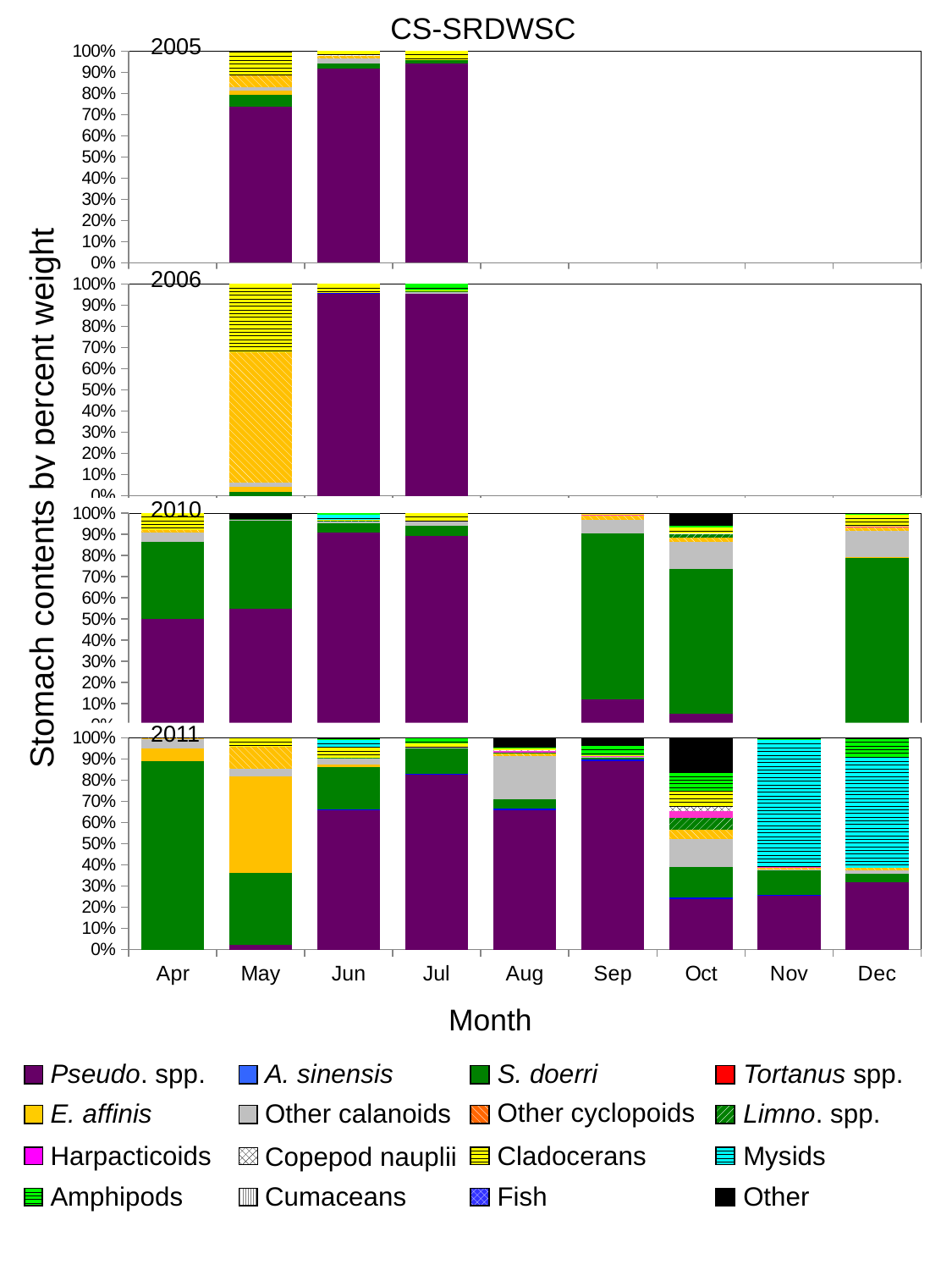
In the 2011 panel, how many months have a bar plotted? 9 In the 2006 panel, is the Pseudo. spp. share for May greater or less than 10%? less What kind of chart is shown on the slide? Stacked bar chart In the 2005 panel, how many months have a bar plotted? 3 In the 2011 panel, is the S. doerri share for Apr greater or less than 80%? greater What is the title of the chart? CS-SRDWSC How many months are labelled on the x axis? 9 In the 2010 panel, which is larger for Apr: the Pseudo. spp. share or the S. doerri share? Pseudo. spp. In the 2011 panel, is the Mysids share for Nov greater or less than 50%? greater How many series does the legend list? 16